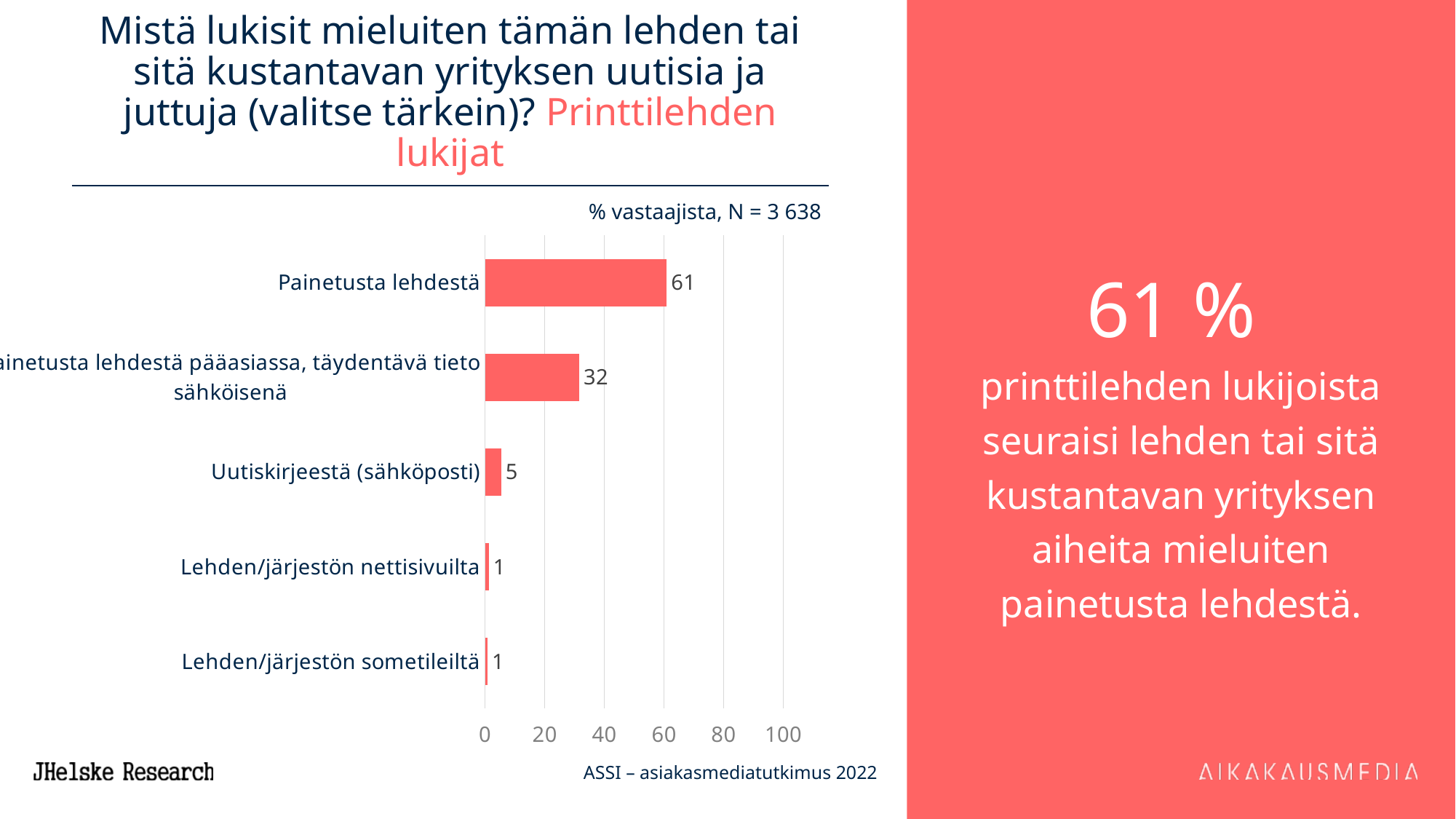
How many categories are shown in the chart? 5 What is the difference between the values for 'Painetusta lehdestä pääasiassa, täydentävä tieto sähköisenä' and Uutiskirjeestä (sähköposti)? 27 What is the value for the category 'Painetusta lehdestä pääasiassa, täydentävä tieto sähköisenä'? 32 What is the value for Uutiskirjeestä (sähköposti)? 5 What is the difference between the values for Painetusta lehdestä and 'Painetusta lehdestä pääasiassa, täydentävä tieto sähköisenä'? 29 What kind of chart is shown on the slide? bar chart What is the value for Painetusta lehdestä? 61 What is the N (number of respondents) stated above the chart? 3 638 Which category has the highest value? Painetusta lehdestä What is the value for Lehden/järjestön nettisivuilta? 1 Which is larger: the value for Uutiskirjeestä (sähköposti) or for Lehden/järjestön nettisivuilta? Uutiskirjeestä (sähköposti) Is the value for Painetusta lehdestä greater or less than 40? greater